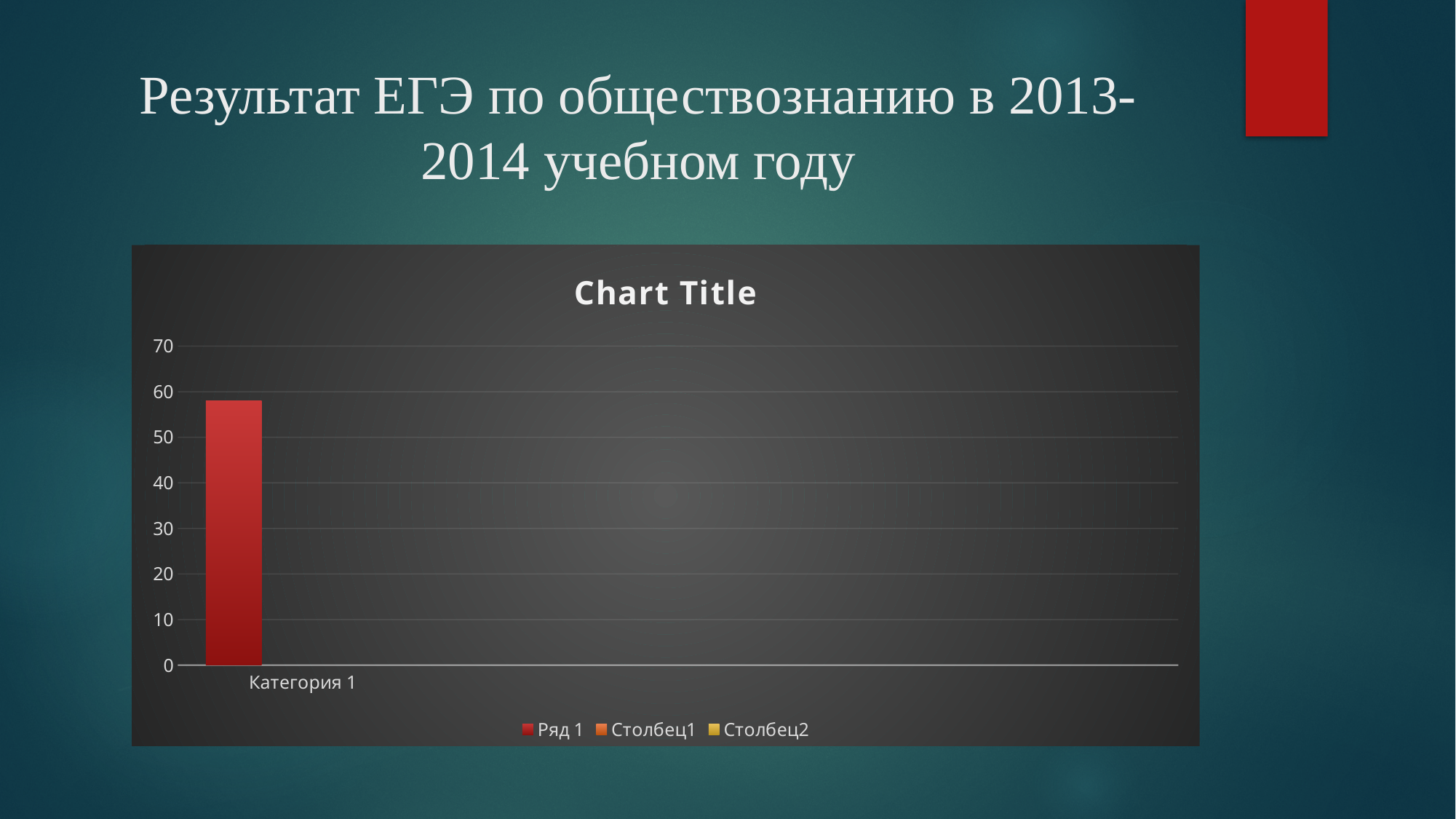
Is the value for Ряд 1 in Категория 1 greater or less than 60? less Is the value for Ряд 1 in Категория 1 greater or less than 40? greater How many series does the chart legend list? 3 What is the highest value shown on the y axis of the chart? 70 How many categories are shown on the x axis of the chart? 1 What kind of chart is shown on the slide? bar chart What is the label of the only category on the x axis? Категория 1 What is the title shown above the chart? Chart Title Is the value for Ряд 1 in Категория 1 greater or less than 50? greater Which series is shown in red in the chart legend? Ряд 1